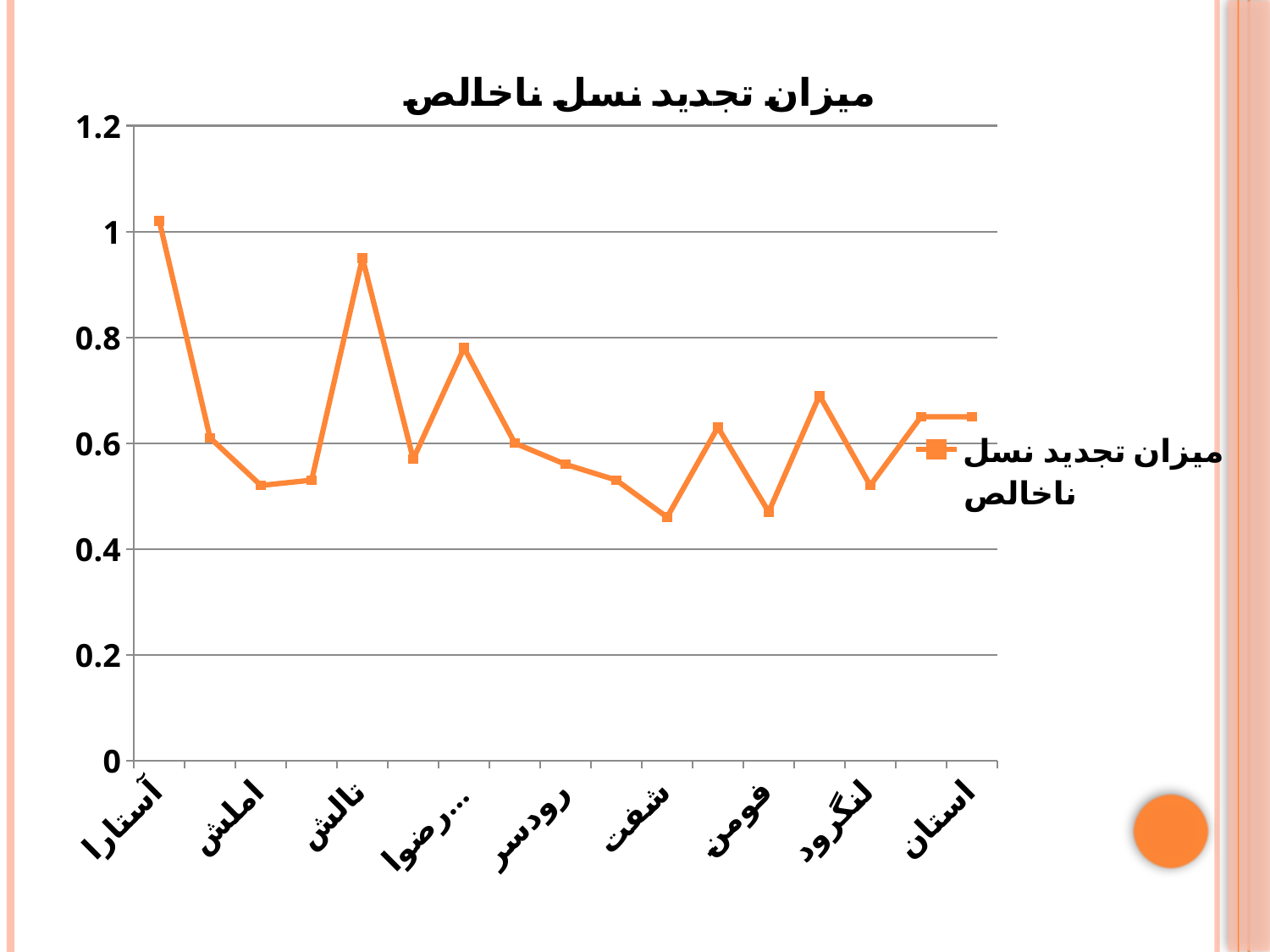
Which labelled category has the highest value? آستارا Is the value for استان greater or less than 0.6? greater How many series does the legend list? 1 What is the title of the chart? میزان تجدید نسل ناخالص Does the line start higher or lower at the left end than it ends at the right end? higher Is the value for لنگرود greater or less than 0.6? less Is the value for آستارا greater or less than 1? greater Which is larger, the value for آستارا or the value for تالش? آستارا What kind of chart is shown on the slide? line chart Which is larger, the value for استان or the value for شفت? استان